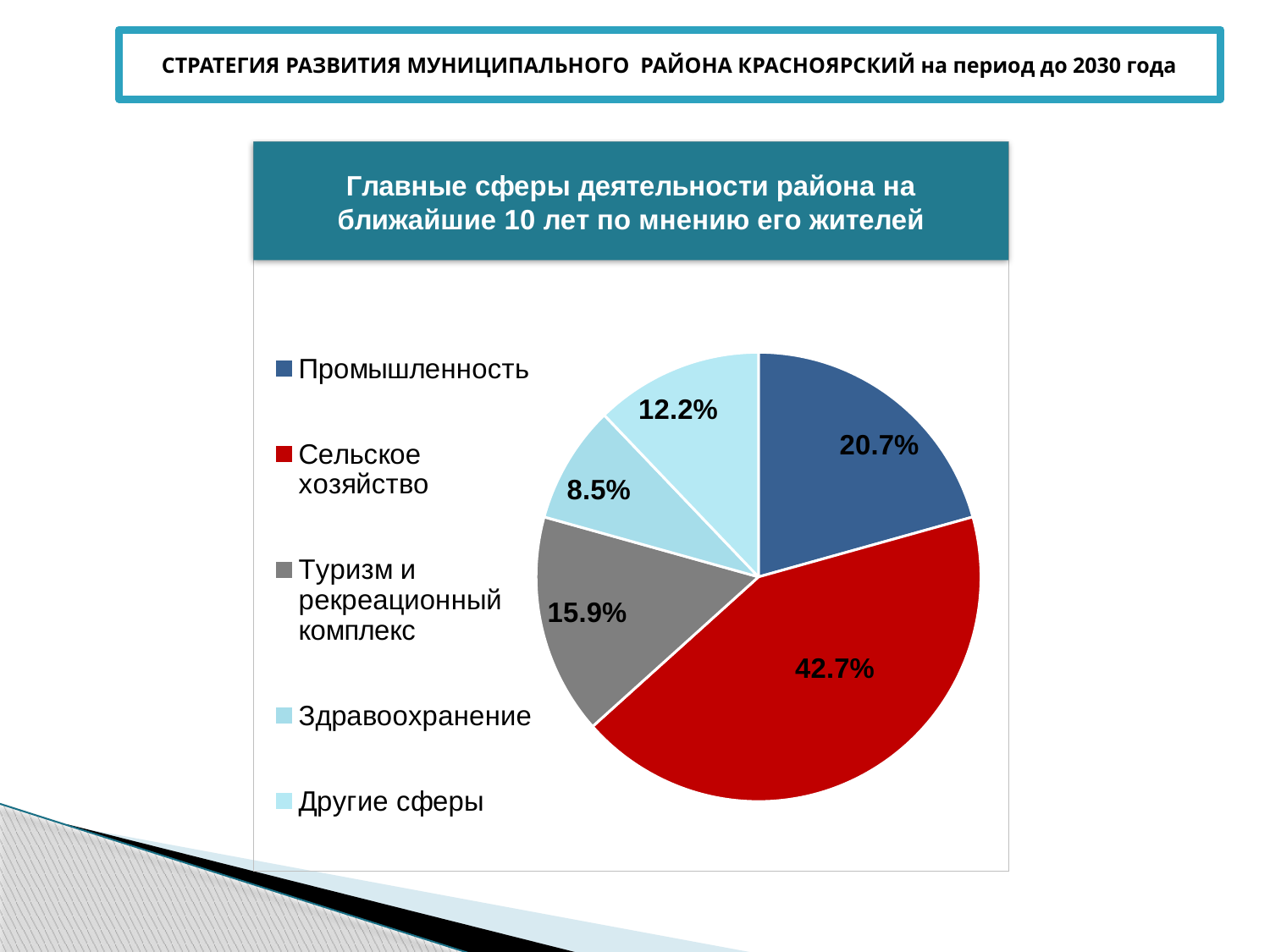
What share of the pie does Промышленность have? 20.7% Which category has the smallest slice of the pie? Здравоохранение What share of the pie does Здравоохранение have? 8.5% What share of the pie does Другие сферы have? 12.2% What is the difference in percentage points between Сельское хозяйство and Промышленность? 22.0 What share of the pie does Сельское хозяйство have? 42.7% How many categories does the pie chart show? 5 What type of chart is shown on the slide? Pie chart Which category has the largest slice of the pie? Сельское хозяйство What share of the pie does Туризм и рекреационный комплекс have? 15.9% What is the title of the chart? Главные сферы деятельности района на ближайшие 10 лет по мнению его жителей Which is larger, the slice for Туризм и рекреационный комплекс or the slice for Другие сферы? Туризм и рекреационный комплекс